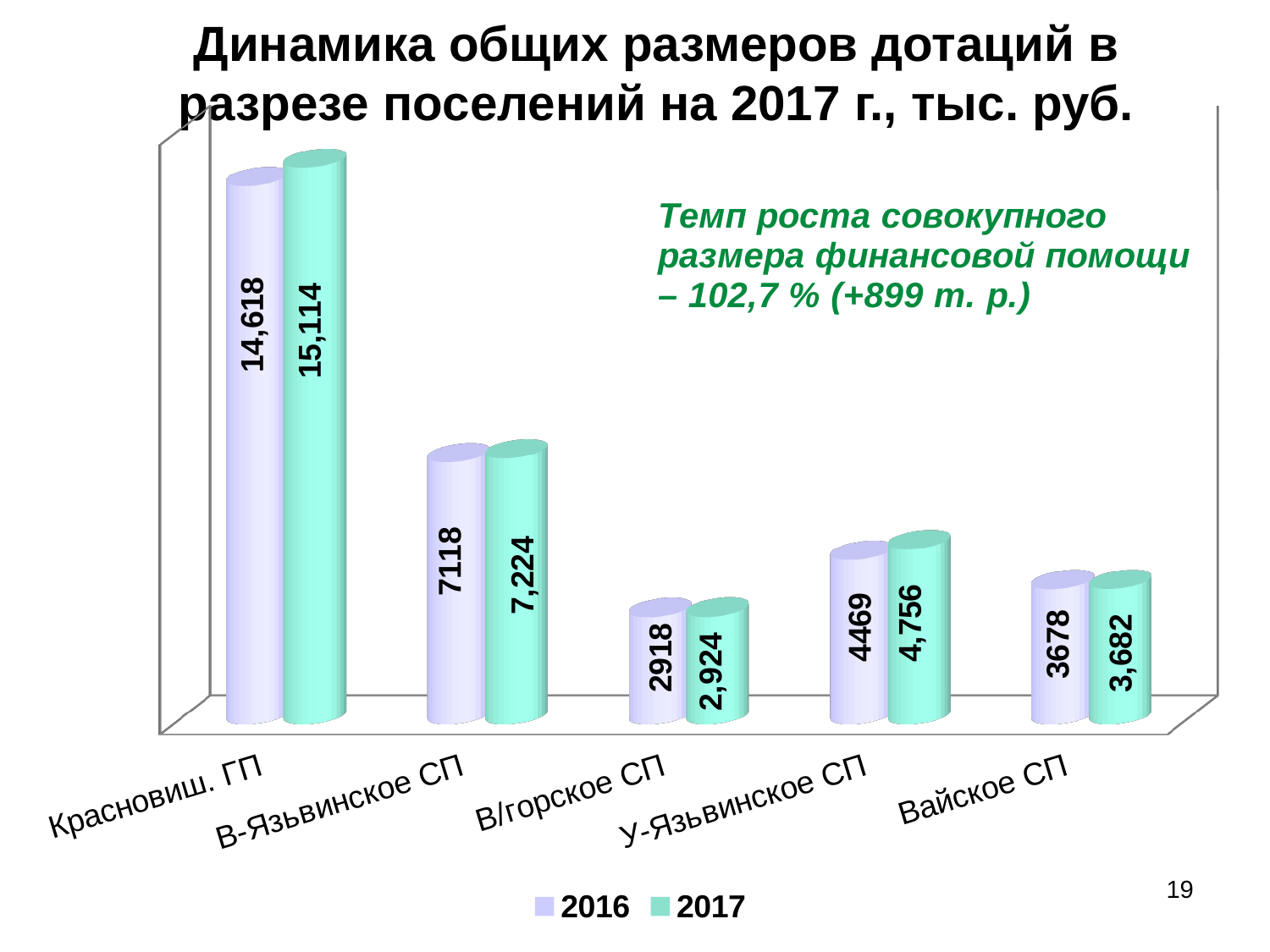
What is the difference between the 2017 and 2016 values for У-Язьвинское СП? 287 Which is larger: the 2016 value for У-Язьвинское СП or the 2016 value for Вайское СП? У-Язьвинское СП How many settlements are shown on the x axis? 5 What is the 2017 value for У-Язьвинское СП? 4,756 Which settlement has the highest 2017 value? Красновиш. ГП What kind of chart is shown on the slide? Bar chart Which settlement has the lowest 2016 value? В/горское СП What is the 2016 value for В/горское СП? 2918 What is the difference between the 2017 and 2016 values for Красновиш. ГП? 496 What is the 2016 value for Красновиш. ГП? 14,618 How many series does the legend list? 2 What is the 2017 value for Вайское СП? 3,682